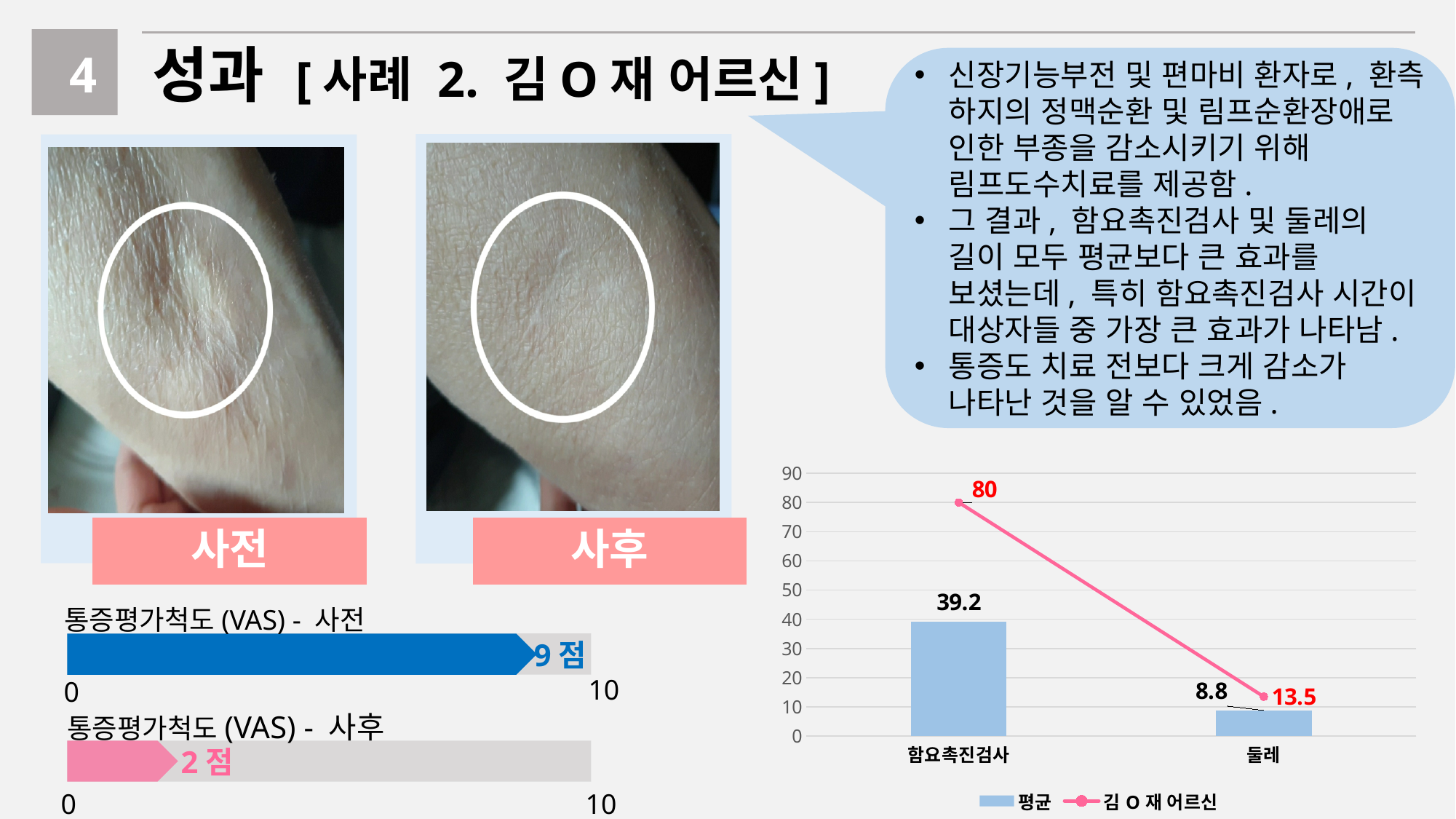
In the chart at the bottom right, what is the difference between the 김 O 재 어르신 value and the 평균 value for 둘레? 4.7 In the chart at the bottom right, what is the 김 O 재 어르신 value for 함요촉진검사? 80 In the chart at the bottom right, which is larger for 둘레: the 평균 value or the 김 O 재 어르신 value? 김 O 재 어르신 In the chart at the bottom right, what is the difference between the 김 O 재 어르신 value and the 평균 value for 함요촉진검사? 40.8 What is the 통증평가척도 (VAS) - 사전 score shown on the left of the slide? 9 점 What is the 통증평가척도 (VAS) - 사후 score shown on the left of the slide? 2 점 In the chart at the bottom right, what is the 김 O 재 어르신 value for 둘레? 13.5 In the chart at the bottom right, what is the 평균 value for 둘레? 8.8 In the chart at the bottom right, how many categories are shown on the x axis? 2 In the chart at the bottom right, does the 김 O 재 어르신 line rise or fall from 함요촉진검사 to 둘레? fall In the chart at the bottom right, how many series does the legend list? 2 In the chart at the bottom right, what is the 평균 value for 함요촉진검사? 39.2